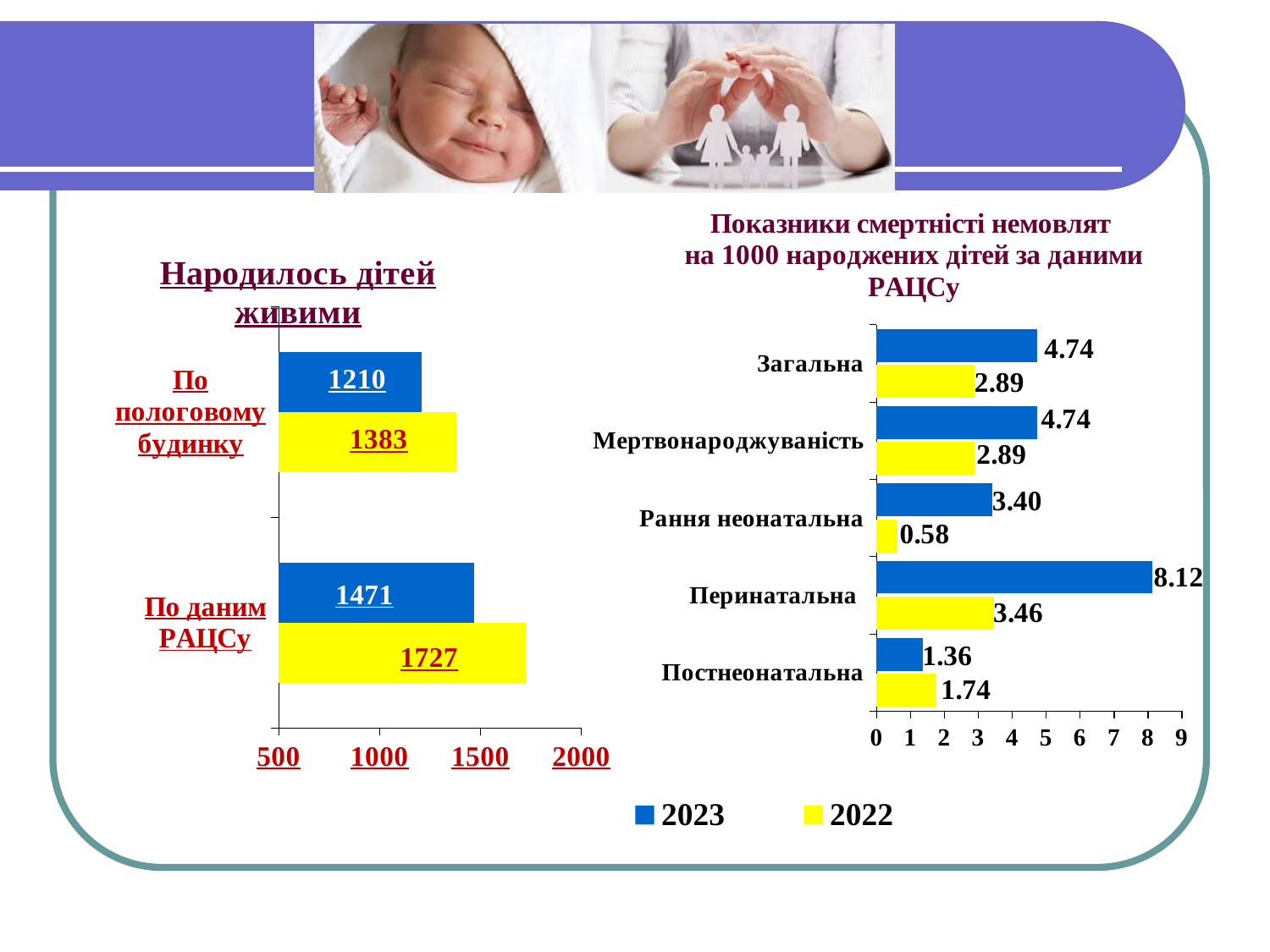
In the chart 'Народилось дітей живими', what is the 2023 value for 'По даним РАЦСу'? 1471 In the chart 'Народилось дітей живими', what is the difference between the 2022 and 2023 values for 'По даним РАЦСу'? 256 In the chart 'Народилось дітей живими', what is the 2022 value for 'По пологовому будинку'? 1383 In the chart 'Показники смертністі немовлят на 1000 народжених дітей за даними РАЦСу', which is larger for 'Постнеонатальна': the 2023 value or the 2022 value? 2022 In the chart 'Народилось дітей живими', how many categories are shown? 2 In the chart 'Показники смертністі немовлят на 1000 народжених дітей за даними РАЦСу', what is the difference between the 2023 and 2022 values for 'Перинатальна'? 4.66 In the chart 'Показники смертністі немовлят на 1000 народжених дітей за даними РАЦСу', what is the 2022 value for 'Рання неонатальна'? 0.58 How many series does the legend list for the charts on the slide? 2 In the chart 'Народилось дітей живими', which is larger for 'По пологовому будинку': the 2023 value or the 2022 value? 2022 In the chart 'Показники смертністі немовлят на 1000 народжених дітей за даними РАЦСу', which category has the highest 2023 value? Перинатальна In the chart 'Показники смертністі немовлят на 1000 народжених дітей за даними РАЦСу', what is the 2023 value for 'Перинатальна'? 8.12 In the chart 'Показники смертністі немовлят на 1000 народжених дітей за даними РАЦСу', which category has the lowest 2022 value? Рання неонатальна